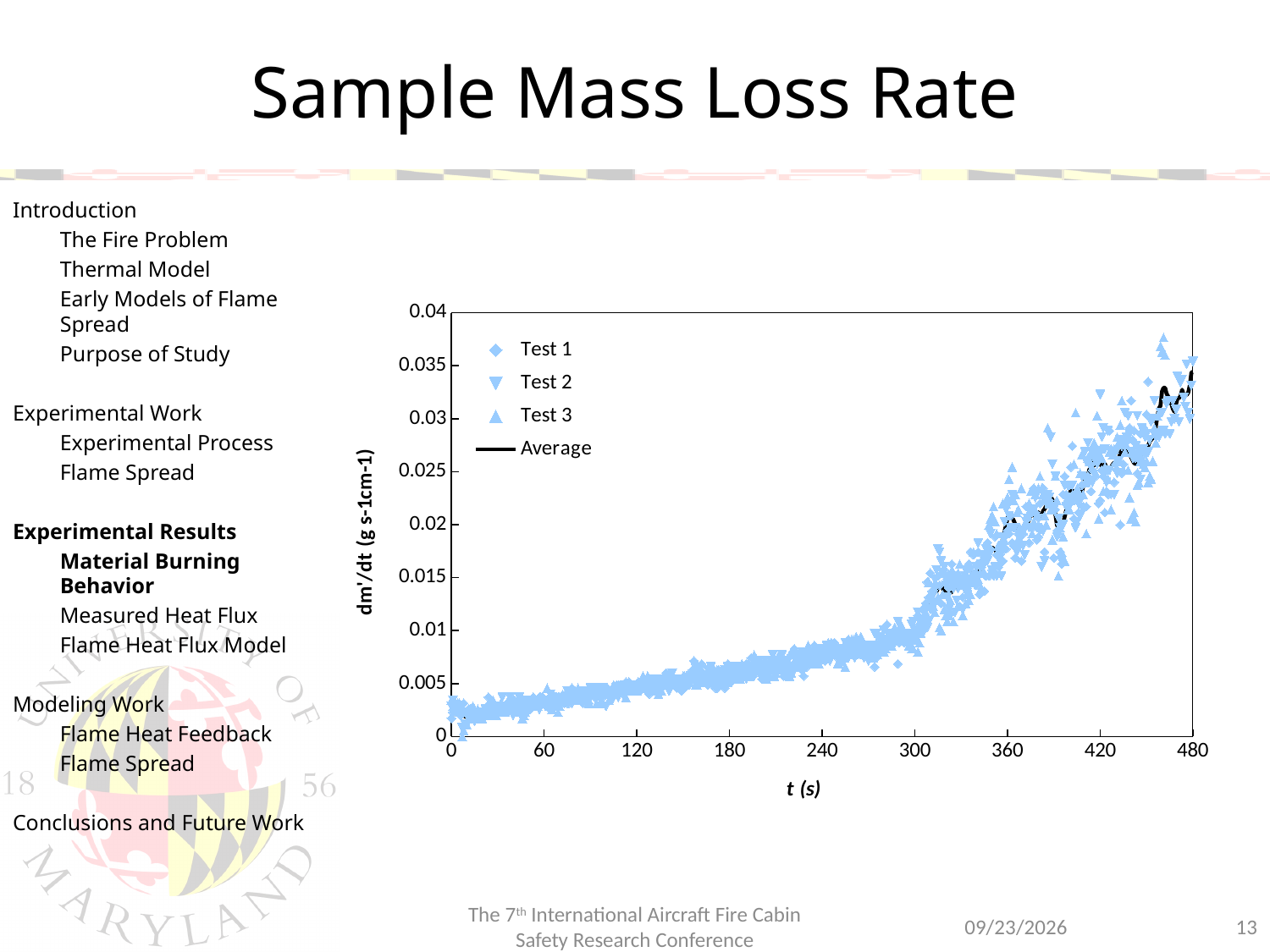
Is the Average value at t = 240 s greater or less than 0.005? greater Is the Average value at t = 420 s greater or less than 0.015? greater How many series does the legend list? 4 What is the highest value shown on the y axis? 0.04 Is the Average value at t = 300 s greater or less than 0.015? less What kind of chart is shown on the slide? scatter chart What are the series names listed in the legend? Test 1, Test 2, Test 3, Average What is the label of the x axis? t (s) Do the mass loss rate values rise or fall as t increases along the x axis? rise